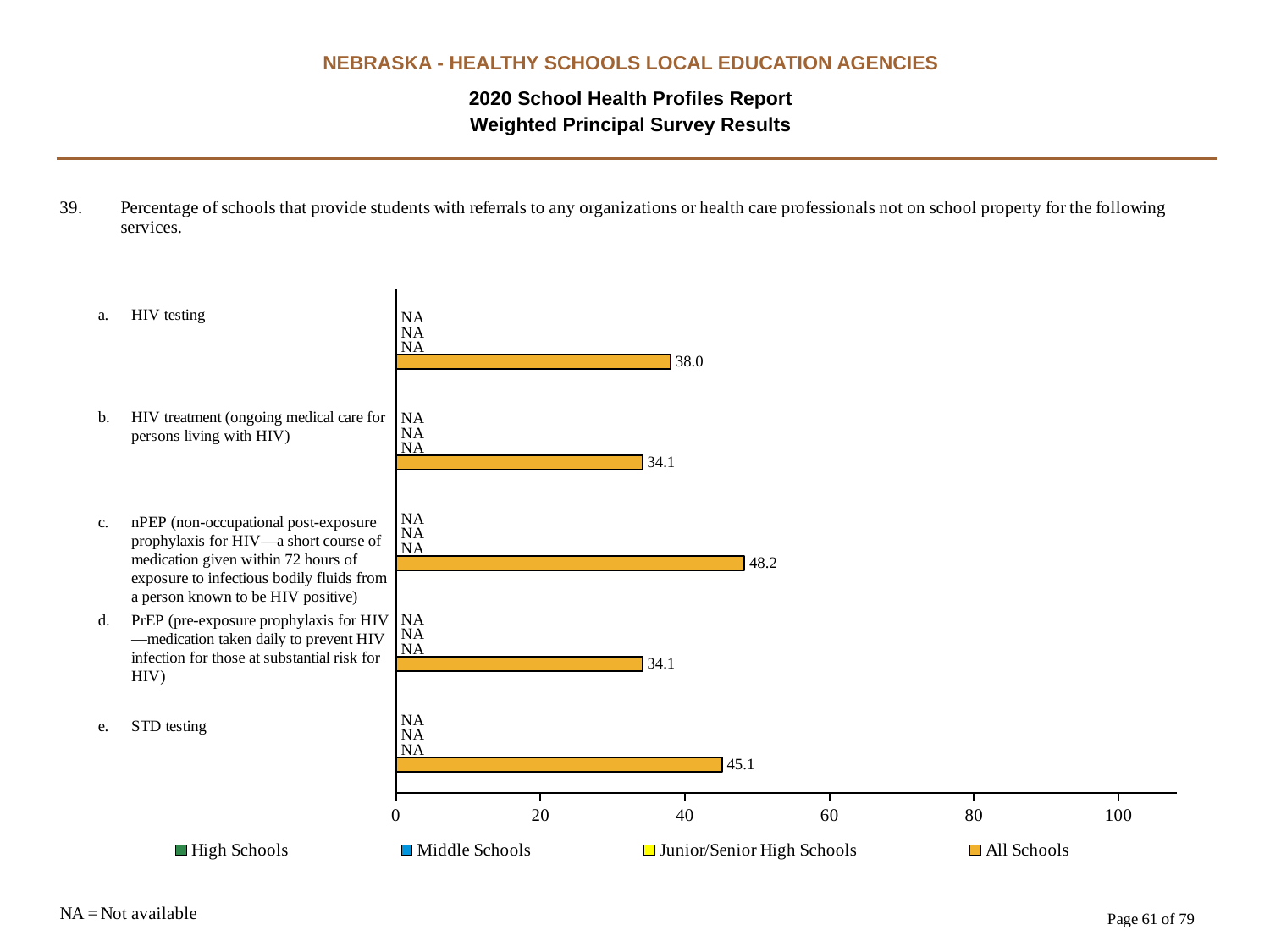
How many services (categories) are shown in the chart? 5 Which service has the highest All Schools value? nPEP What is the All Schools value for STD testing? 45.1 What is the All Schools value for PrEP? 34.1 What kind of chart is shown? bar chart What is the All Schools value for HIV testing? 38.0 How many series does the legend list? 4 What is the All Schools value for nPEP? 48.2 Is the All Schools value for STD testing greater or less than 40? greater What value is shown for High Schools for HIV testing? NA Which is larger for All Schools: STD testing or HIV treatment? STD testing What is the difference between the All Schools values for nPEP and HIV testing? 10.2